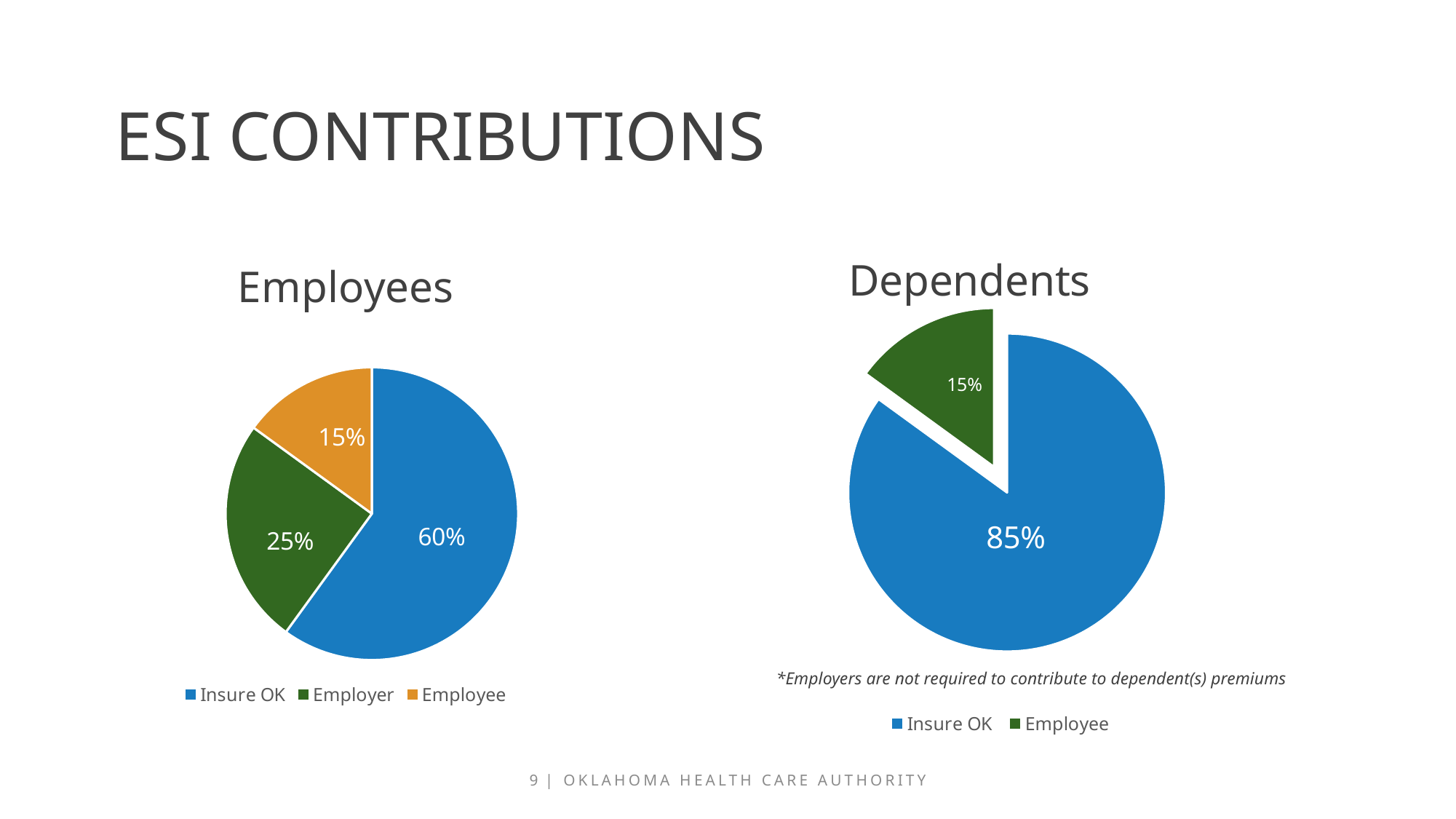
In the Employees chart, what is the difference between the Insure OK share and the Employer share? 35% In the Employees chart, what share does the Employer contribute? 25% In the Employees chart, which contributor has the largest slice? Insure OK In the Employees chart, which contributor has the smallest slice? Employee In the Dependents chart, what share does the Employee contribute? 15% In the Employees chart, what share does the Employee contribute? 15% In the Employees chart, which is larger, the Employer share or the Employee share? Employer In the Employees chart, what share does Insure OK contribute? 60% In the Dependents chart, what is the difference between the Insure OK share and the Employee share? 70% How many slices does the Employees chart have? 3 What type of chart is the Dependents chart? Pie chart In the Dependents chart, what share does Insure OK contribute? 85%